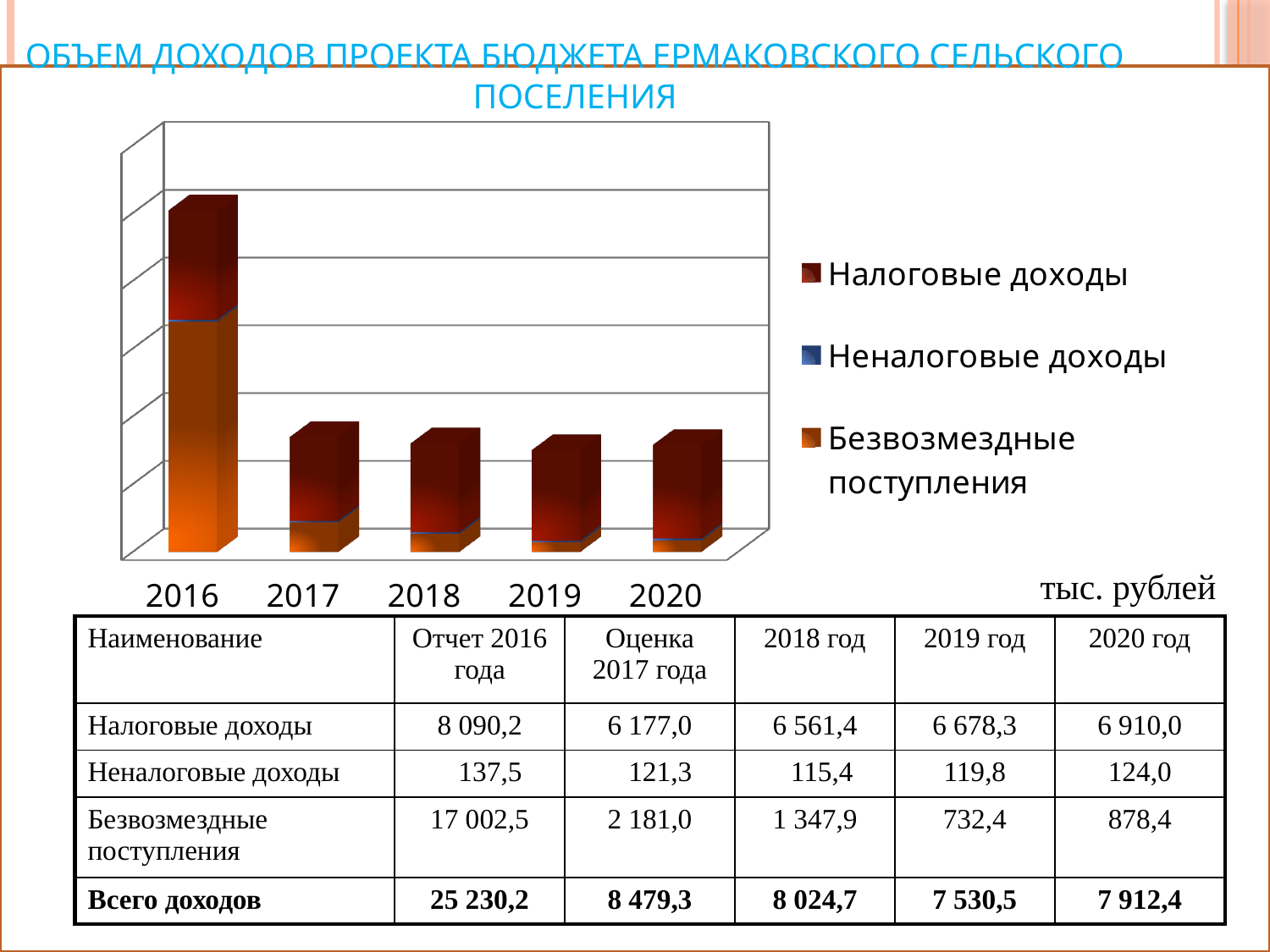
By how much do Налоговые доходы in 2020 год exceed those in 2019 год? 231,7 Which is larger: Безвозмездные поступления in Оценка 2017 года or in 2018 год? Оценка 2017 года In what units are the values given, as stated above the table? тыс. рублей Which year has the tallest stacked bar in the chart? 2016 How many years are shown along the x axis of the chart? 5 What is the total income (Всего доходов) for 2020 год? 7 912,4 What kind of chart is shown on the slide? Stacked bar chart What is the value of Безвозмездные поступления for Отчет 2016 года? 17 002,5 Do Безвозмездные поступления rise or fall from 2016 to 2019? Fall According to the table, which year has the lowest value of Всего доходов? 2019 год How many series does the chart legend list? 3 What is the value of Налоговые доходы for 2018 год in the table? 6 561,4